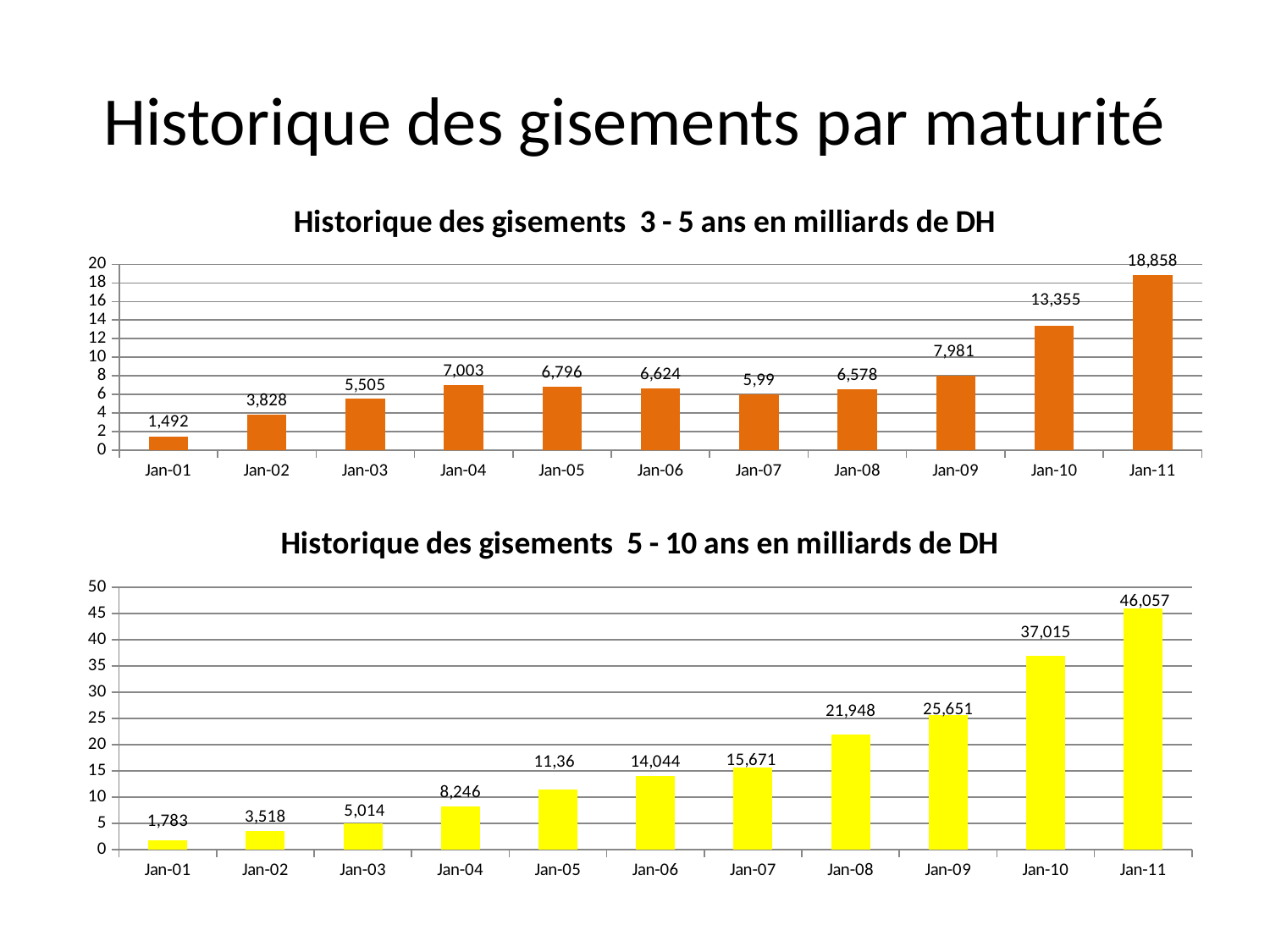
In the bottom chart (Historique des gisements 5 - 10 ans), do the values rise or fall from Jan-01 to Jan-11? Rise In the top chart (Historique des gisements 3 - 5 ans), what is the value for Jan-07? 5,99 In the bottom chart (Historique des gisements 5 - 10 ans), which year has the highest value? Jan-11 In the top chart (Historique des gisements 3 - 5 ans), which year has the lowest value? Jan-01 In the top chart (Historique des gisements 3 - 5 ans), what is the value for Jan-11? 18,858 How many years (bars) are shown in the bottom chart (Historique des gisements 5 - 10 ans)? 11 What type of chart is the top chart (Historique des gisements 3 - 5 ans)? Bar chart In the bottom chart (Historique des gisements 5 - 10 ans), what is the value for Jan-05? 11,36 In the bottom chart (Historique des gisements 5 - 10 ans), what is the difference between the values for Jan-09 and Jan-08? 3,703 In the top chart (Historique des gisements 3 - 5 ans), what is the difference between the values for Jan-11 and Jan-10? 5,503 In the bottom chart (Historique des gisements 5 - 10 ans), what is the value for Jan-10? 37,015 In the top chart (Historique des gisements 3 - 5 ans), which is larger, the value for Jan-04 or the value for Jan-09? Jan-09